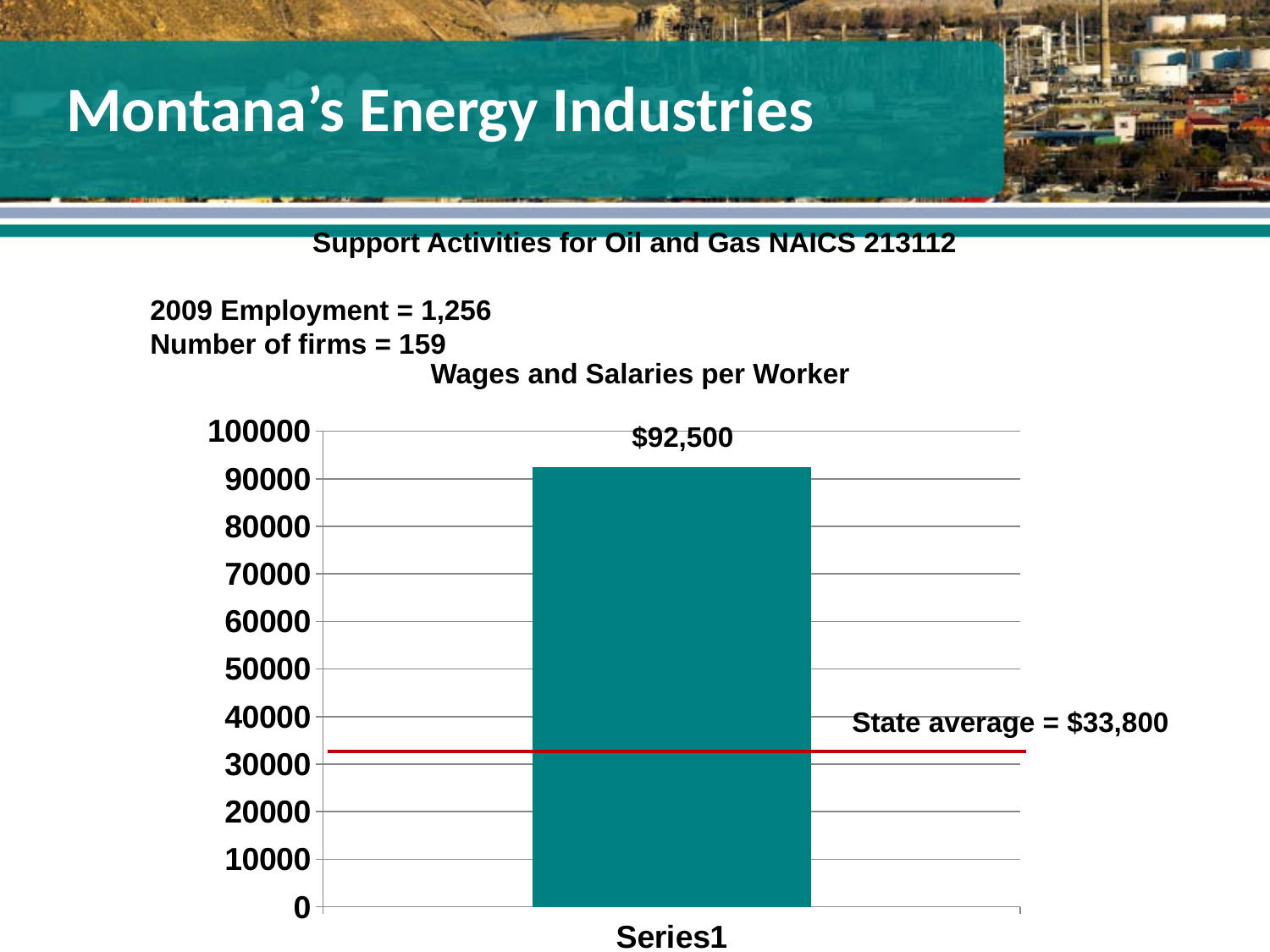
Is the value of the bar in the chart greater or less than 100000? less What kind of chart is shown on the slide? bar chart What is the difference between the bar value and the state average shown on the chart? $58,700 Which is larger: the bar value of $92,500 or the state average of $33,800? $92,500 What is the category label shown under the bar on the x axis? Series1 Is the state average line on the chart above or below the 40000 gridline? below How many bars are plotted in the Wages and Salaries per Worker chart? 1 What is the state average shown by the red line on the chart? $33,800 What is the title of the chart on the slide? Wages and Salaries per Worker What is the highest value shown on the y axis of the chart? 100000 Is the value of the bar in the chart greater or less than 90000? greater What is the value of the bar in the Wages and Salaries per Worker chart? $92,500